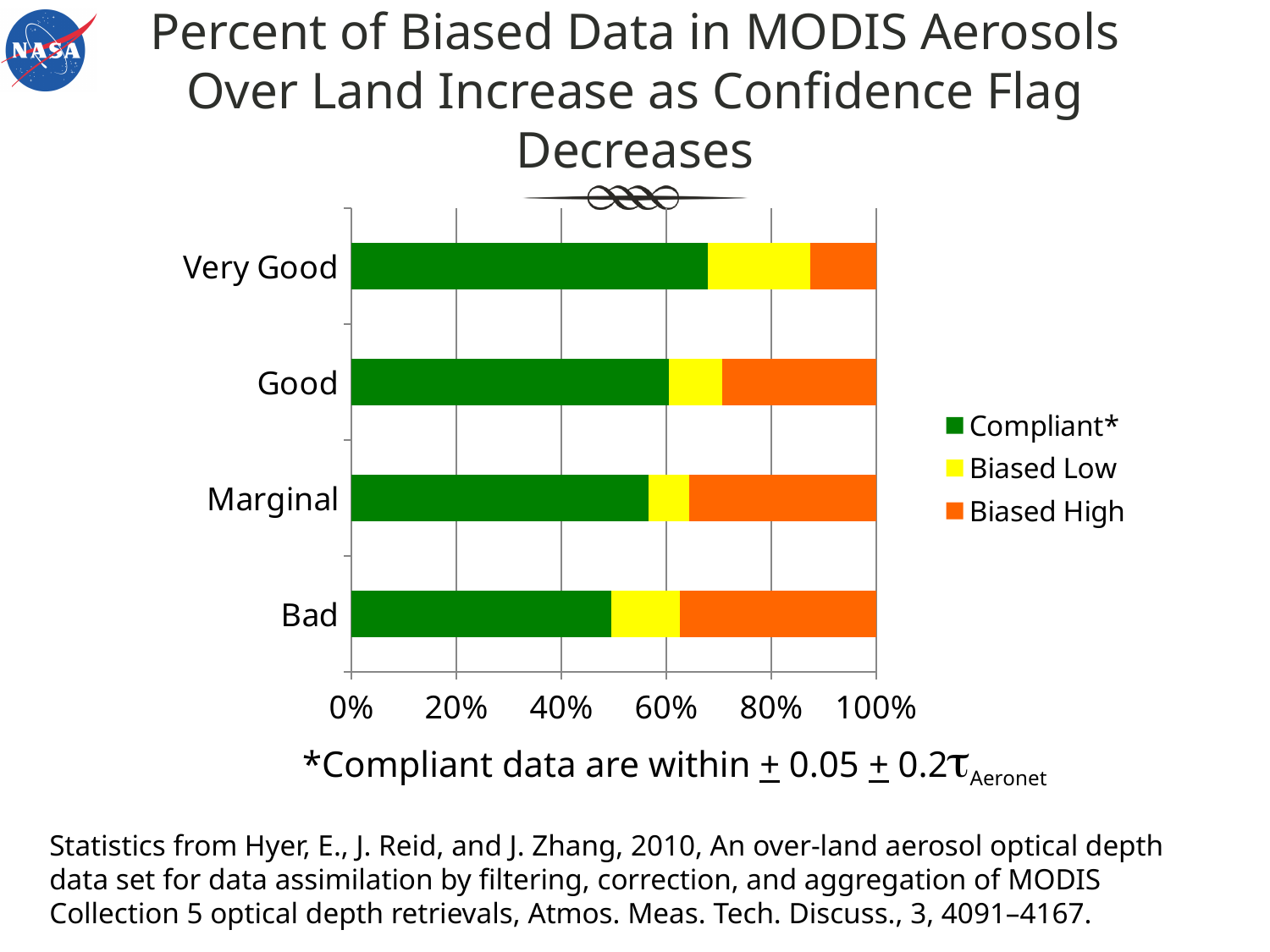
Which has the larger Biased High share, Very Good or Good? Good Which confidence flag category has the smallest Compliant* share? Bad Is the Compliant* share for Bad greater or less than 60%? less How many confidence flag categories are shown on the chart? 4 Which category has the smallest Biased High share? Very Good Is the Compliant* share for Very Good greater or less than 60%? greater Which confidence flag category has the largest Compliant* share? Very Good Is the Compliant* share for Marginal greater or less than 60%? less What colour represents the Compliant* series in the chart? Green How many series does the chart legend list? 3 Which category has the largest Biased Low share? Very Good What kind of chart is shown on the slide? Stacked bar chart